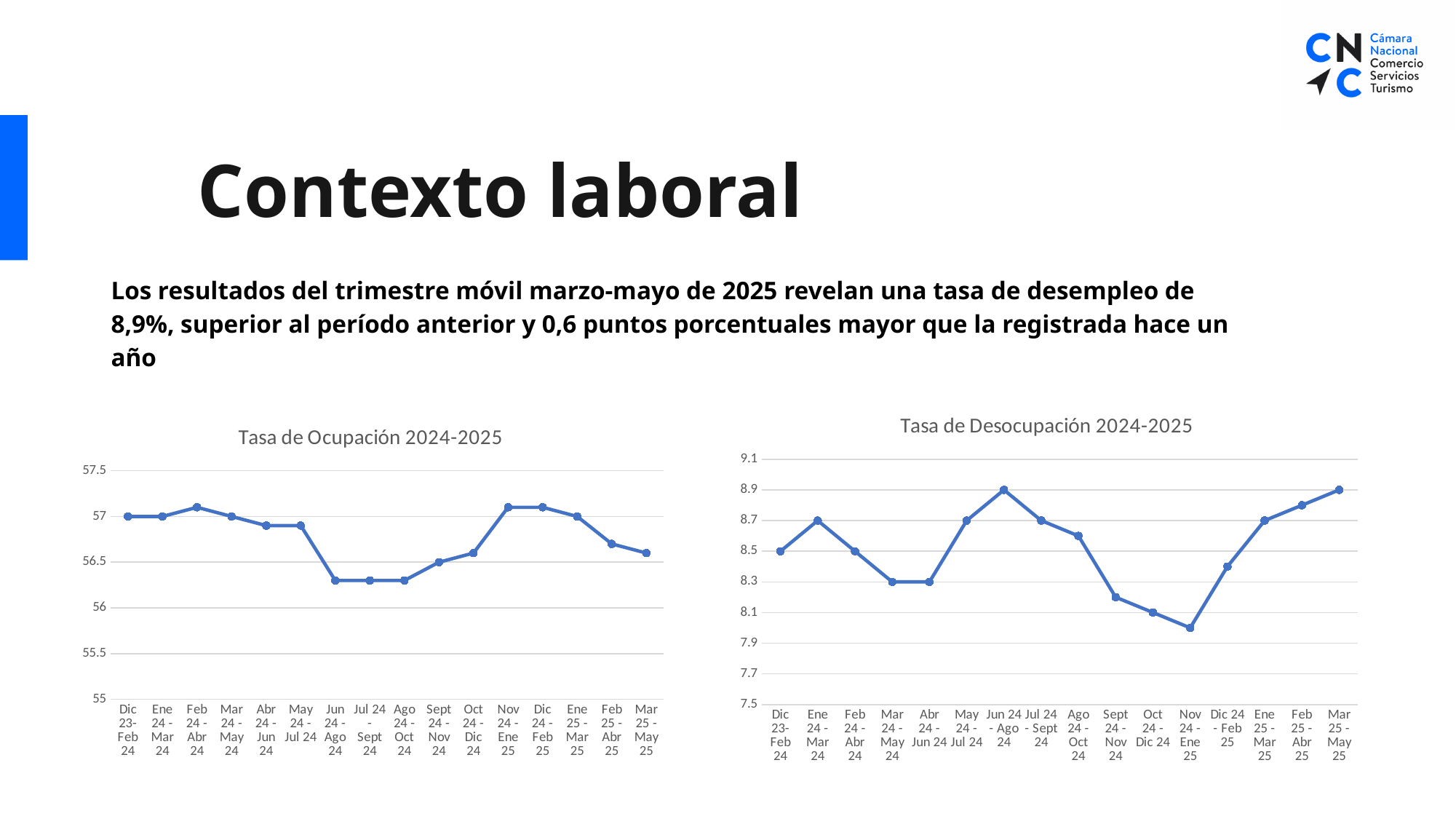
How many data points are plotted in the 'Tasa de Desocupación 2024-2025' chart? 16 In the 'Tasa de Desocupación 2024-2025' chart, which is larger: the value for Jun 24 - Ago 24 or the value for Oct 24 - Dic 24? Jun 24 - Ago 24 In the 'Tasa de Desocupación 2024-2025' chart, which period has the lowest value? Nov 24 - Ene 25 What is the title of the chart on the right side of the slide? Tasa de Desocupación 2024-2025 In the 'Tasa de Desocupación 2024-2025' chart, do the values rise or fall from Nov 24 - Ene 25 to Mar 25 - May 25? rise In the 'Tasa de Desocupación 2024-2025' chart, is the value for Nov 24 - Ene 25 greater or less than 8.1? less In the 'Tasa de Desocupación 2024-2025' chart, what is the difference between the value for Mar 25 - May 25 and the value for Dic 23 - Feb 24? 0.4 What kind of chart is the 'Tasa de Ocupación 2024-2025' chart? line chart In the 'Tasa de Desocupación 2024-2025' chart, what is the value for Dic 23 - Feb 24? 8.5 In the 'Tasa de Ocupación 2024-2025' chart, is the value for Jun 24 - Ago 24 greater or less than 56.5? less In the 'Tasa de Desocupación 2024-2025' chart, what is the value for Mar 25 - May 25? 8.9 In the 'Tasa de Ocupación 2024-2025' chart, what is the value for Dic 23 - Feb 24? 57